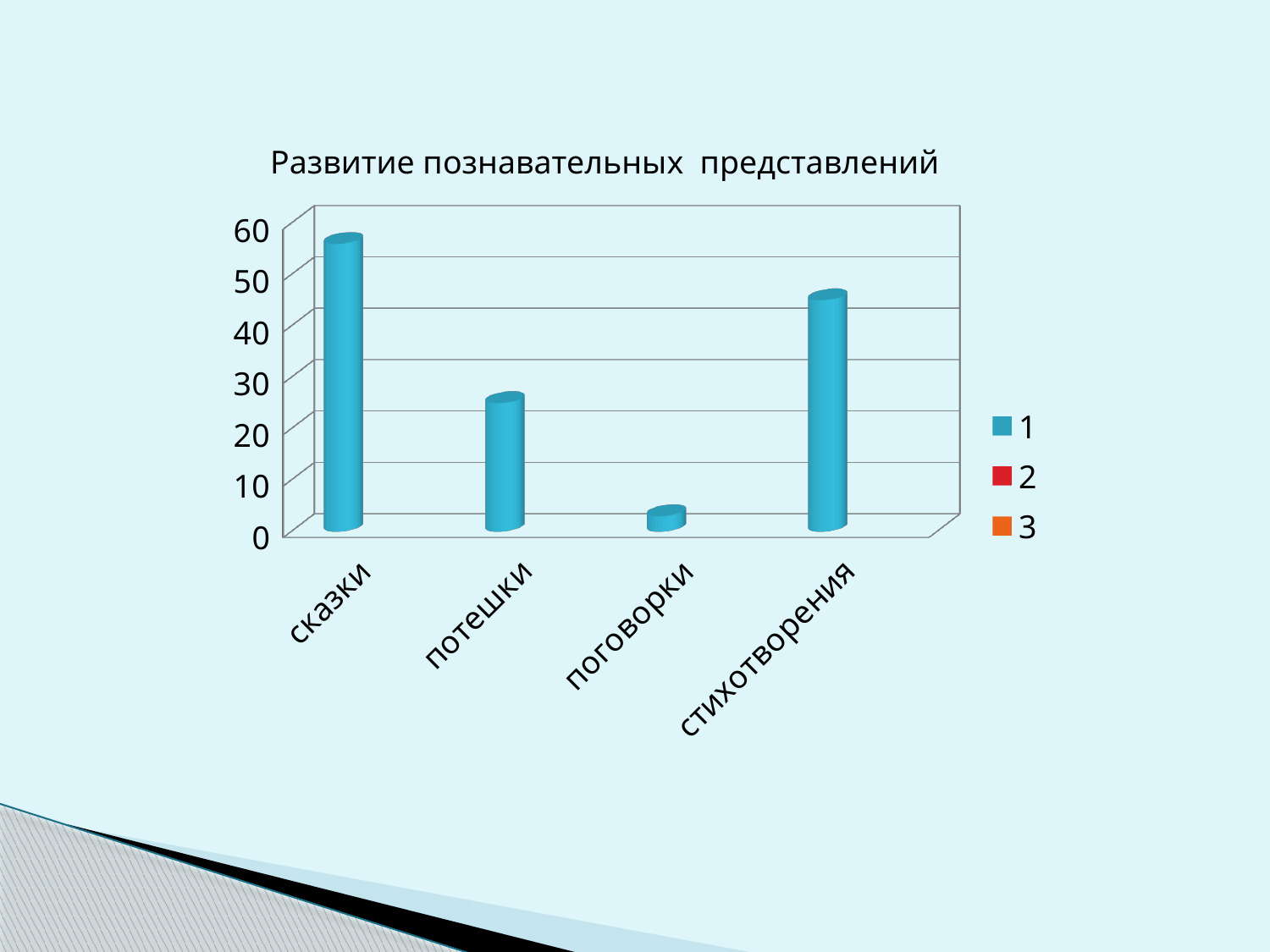
Which category has the highest bar in the chart? сказки Is the value for сказки greater or less than 50? greater How many categories are shown on the x axis of the chart? 4 Is the value for стихотворения greater or less than 40? greater How many series does the chart legend list? 3 Is the value for потешки greater or less than 20? greater What kind of chart is shown on the slide? bar chart Which is larger, the value for сказки or the value for стихотворения? сказки Which category has the lowest bar in the chart? поговорки Which is larger, the value for потешки or the value for стихотворения? стихотворения What is the title of the chart? Развитие познавательных представлений